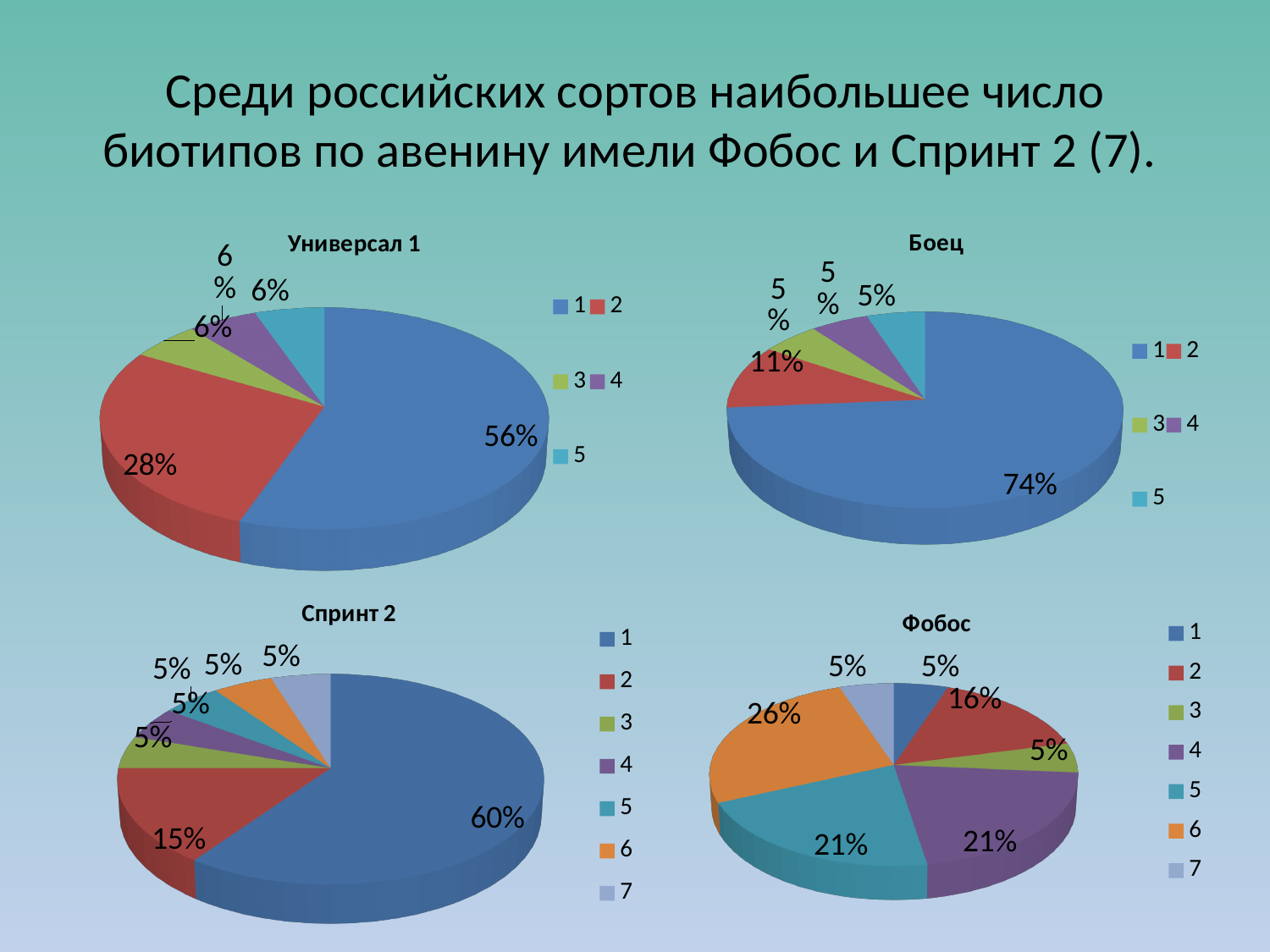
In the Боец chart, what share does slice 2 have? 11% In the Боец chart, what share does slice 1 have? 74% In the Фобос chart, what share does slice 6 have? 26% In the Универсал 1 chart, what share does slice 1 have? 56% How many series does the legend of the Спринт 2 chart list? 7 In the Фобос chart, what is the difference between slice 6 and slice 2? 10% What kind of chart is the Фобос chart? pie chart In the Спринт 2 chart, what share does slice 1 have? 60% In the Фобос chart, which slice is the largest? 6 In the Универсал 1 chart, what share does slice 2 have? 28% How many slices does the Боец chart have? 5 In the Спринт 2 chart, which is larger, slice 1 or slice 2? 1